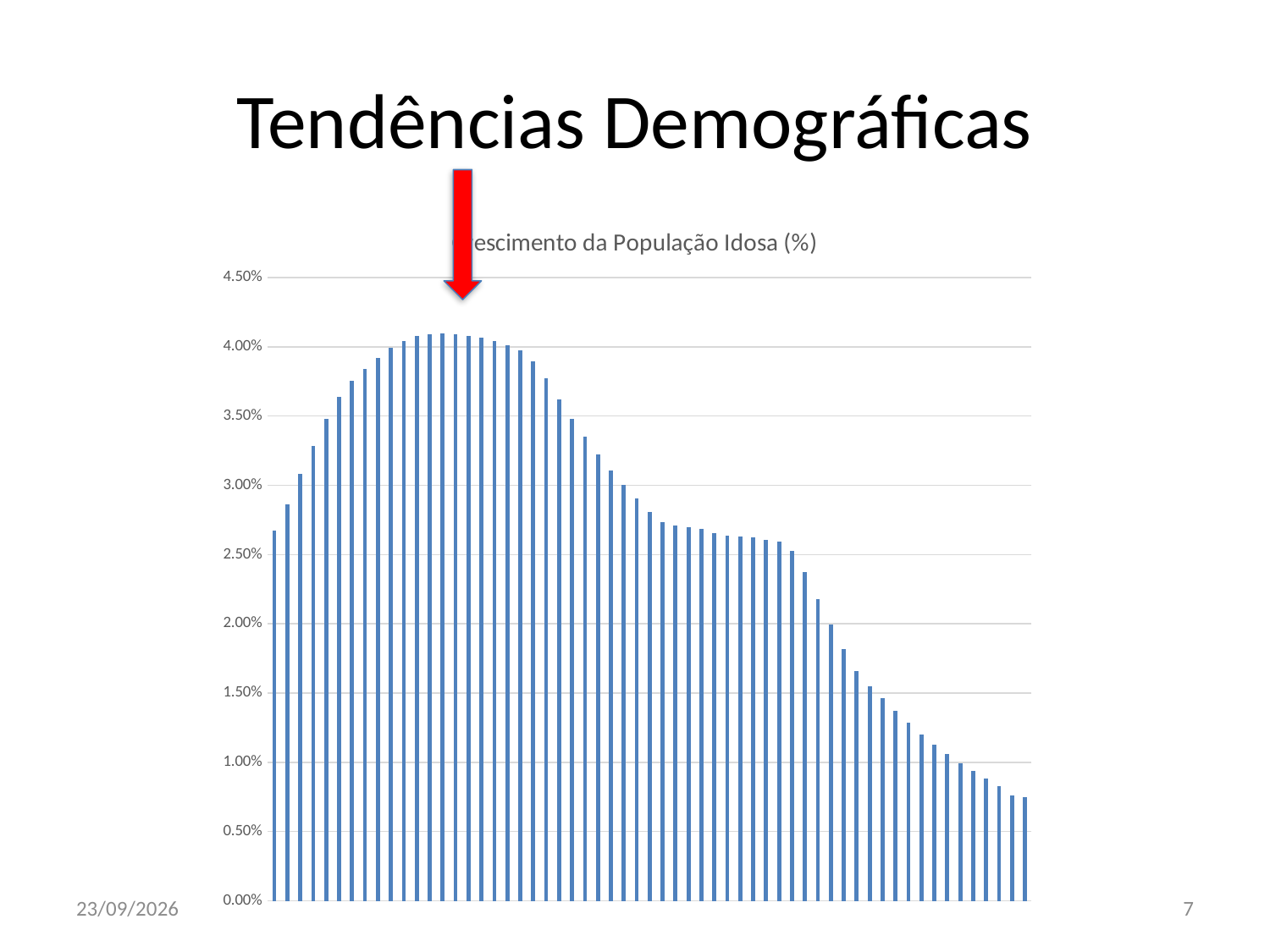
What is the highest value shown on the chart's vertical axis? 4.50% What is the title of the chart? Crescimento da População Idosa (%) Is the value of the leftmost bar greater or less than 2.50%? greater Which is larger, the leftmost bar or the rightmost bar? The leftmost bar Is the value of the rightmost bar greater or less than 1.00%? less Is the lowest value on the chart greater or less than 0.50%? greater Do the values rise or fall across the first bars at the left of the chart? Rise What kind of chart is shown on the slide? Bar chart Do the values rise or fall across the right half of the chart? Fall